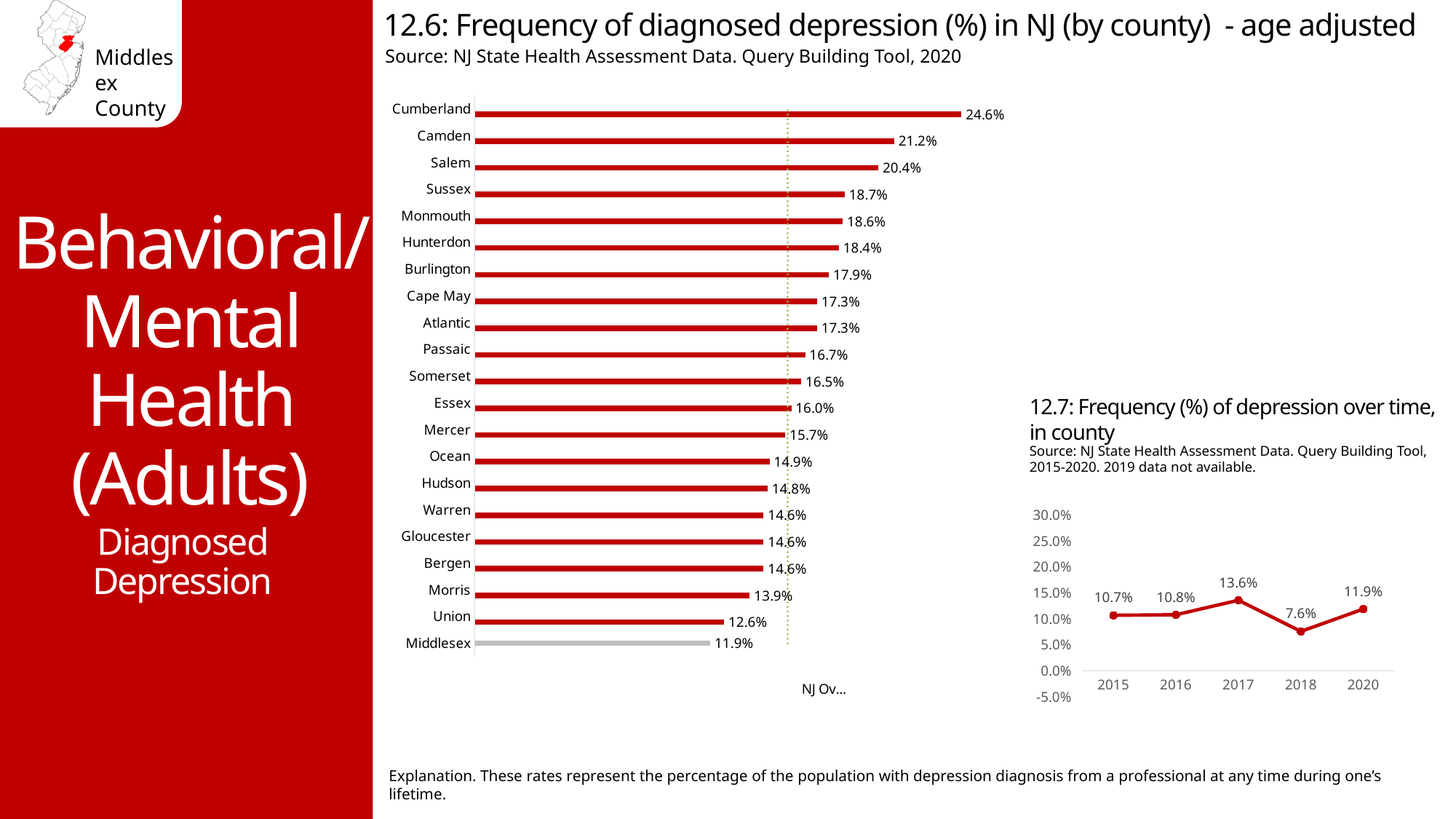
What kind of chart is '12.6: Frequency of diagnosed depression (%) in NJ (by county) - age adjusted'? Bar chart What kind of chart is '12.7: Frequency (%) of depression over time, in county'? Line chart In the chart '12.6: Frequency of diagnosed depression (%) in NJ (by county) - age adjusted', what is the value for Cumberland? 24.6% In the chart '12.6: Frequency of diagnosed depression (%) in NJ (by county) - age adjusted', which county has the highest value? Cumberland In the chart '12.6: Frequency of diagnosed depression (%) in NJ (by county) - age adjusted', how many counties are shown? 21 In the chart '12.6: Frequency of diagnosed depression (%) in NJ (by county) - age adjusted', what is the difference between the values for Cumberland and Middlesex? 12.7% In the chart '12.7: Frequency (%) of depression over time, in county', what is the value for 2018? 7.6% In the chart '12.6: Frequency of diagnosed depression (%) in NJ (by county) - age adjusted', which county has the lowest value? Middlesex In the chart '12.7: Frequency (%) of depression over time, in county', which year has the highest value? 2017 In the chart '12.6: Frequency of diagnosed depression (%) in NJ (by county) - age adjusted', what is the value for Middlesex? 11.9% In the chart '12.6: Frequency of diagnosed depression (%) in NJ (by county) - age adjusted', which has a larger value, Camden or Salem? Camden In the chart '12.7: Frequency (%) of depression over time, in county', what is the difference between the values for 2017 and 2018? 6.0%